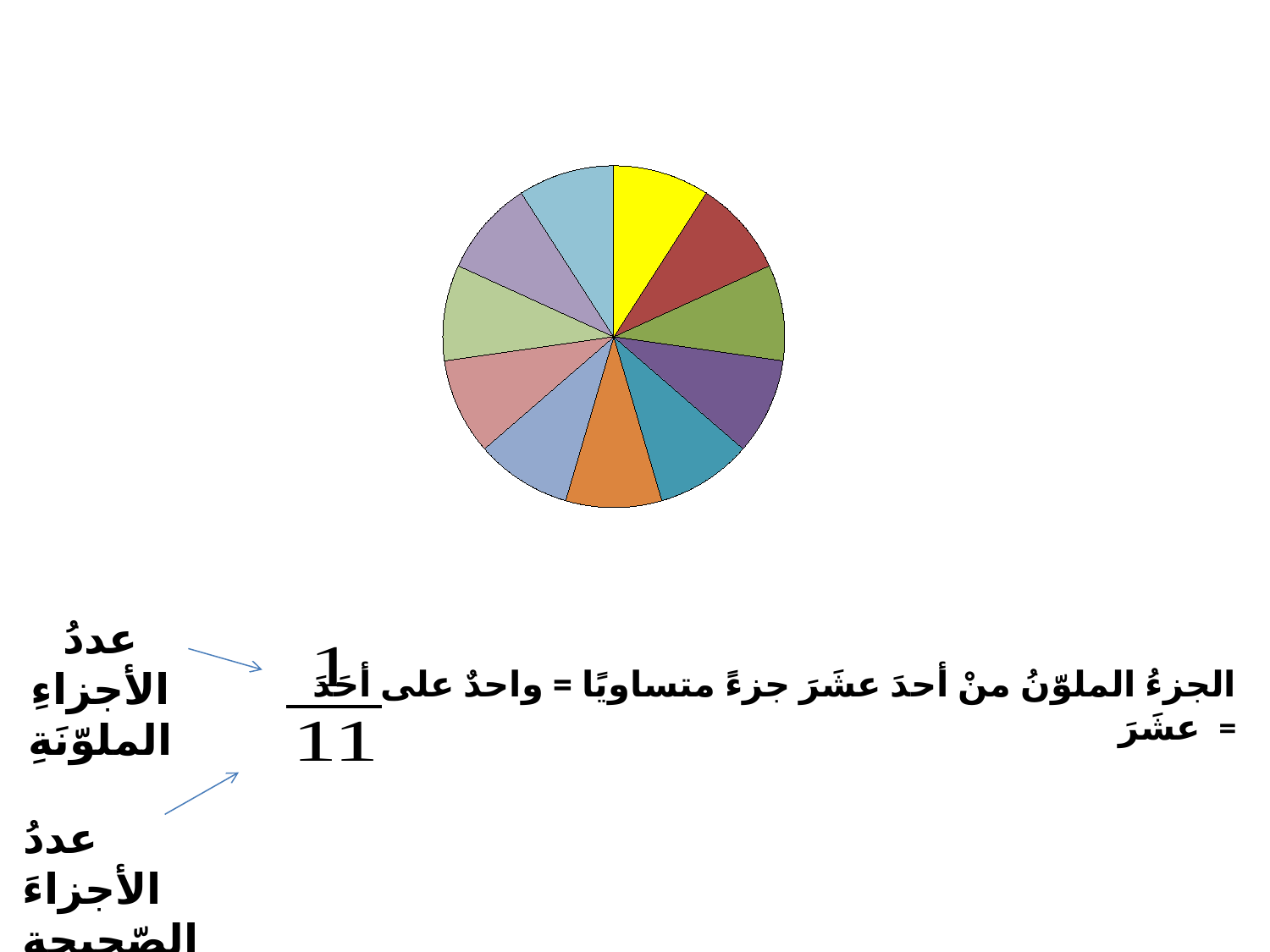
How many slices does the pie chart have? 11 What fraction of the whole pie does a single slice represent, as written on the slide? 1/11 What colour is the slice immediately to the right of the top (12 o'clock) of the pie chart? yellow Are the slices of the pie chart equal in size or different in size? equal What kind of chart is shown on the slide? pie chart Does the pie chart have a legend? No